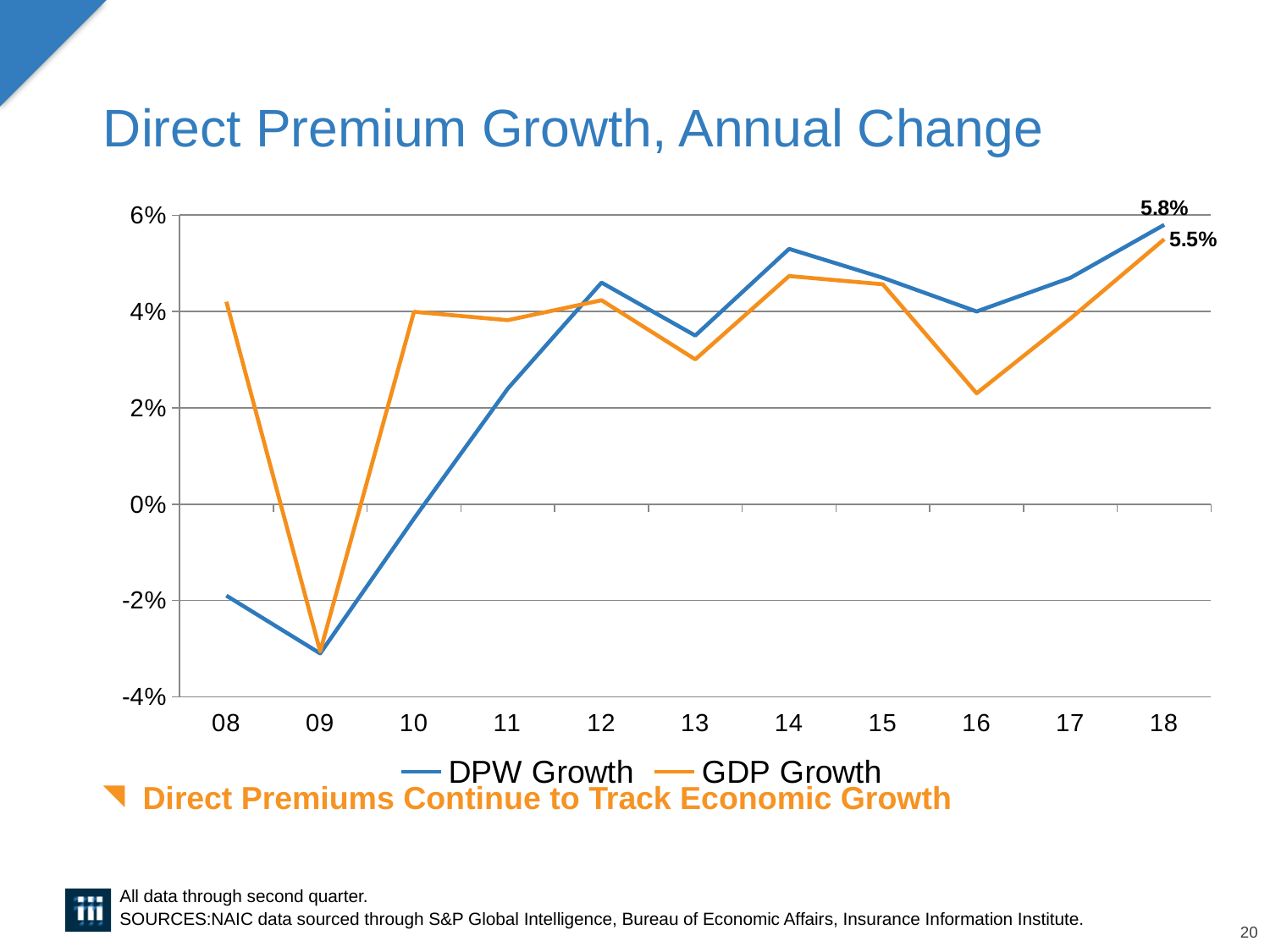
Is the DPW Growth value for 14 greater or less than 4%? greater How many years are shown on the x axis? 11 Is the GDP Growth value for 13 greater or less than 2%? greater In which year is GDP Growth highest? 18 What kind of chart is shown on the slide? Line chart What is the DPW Growth value for 18? 5.8% Is the DPW Growth value for 09 greater or less than -2%? less What is the difference between DPW Growth and GDP Growth in 18? 0.3% What is the GDP Growth value for 18? 5.5% How many series does the legend list? 2 In which year is GDP Growth lowest? 09 In 18, which series has the larger value, DPW Growth or GDP Growth? DPW Growth